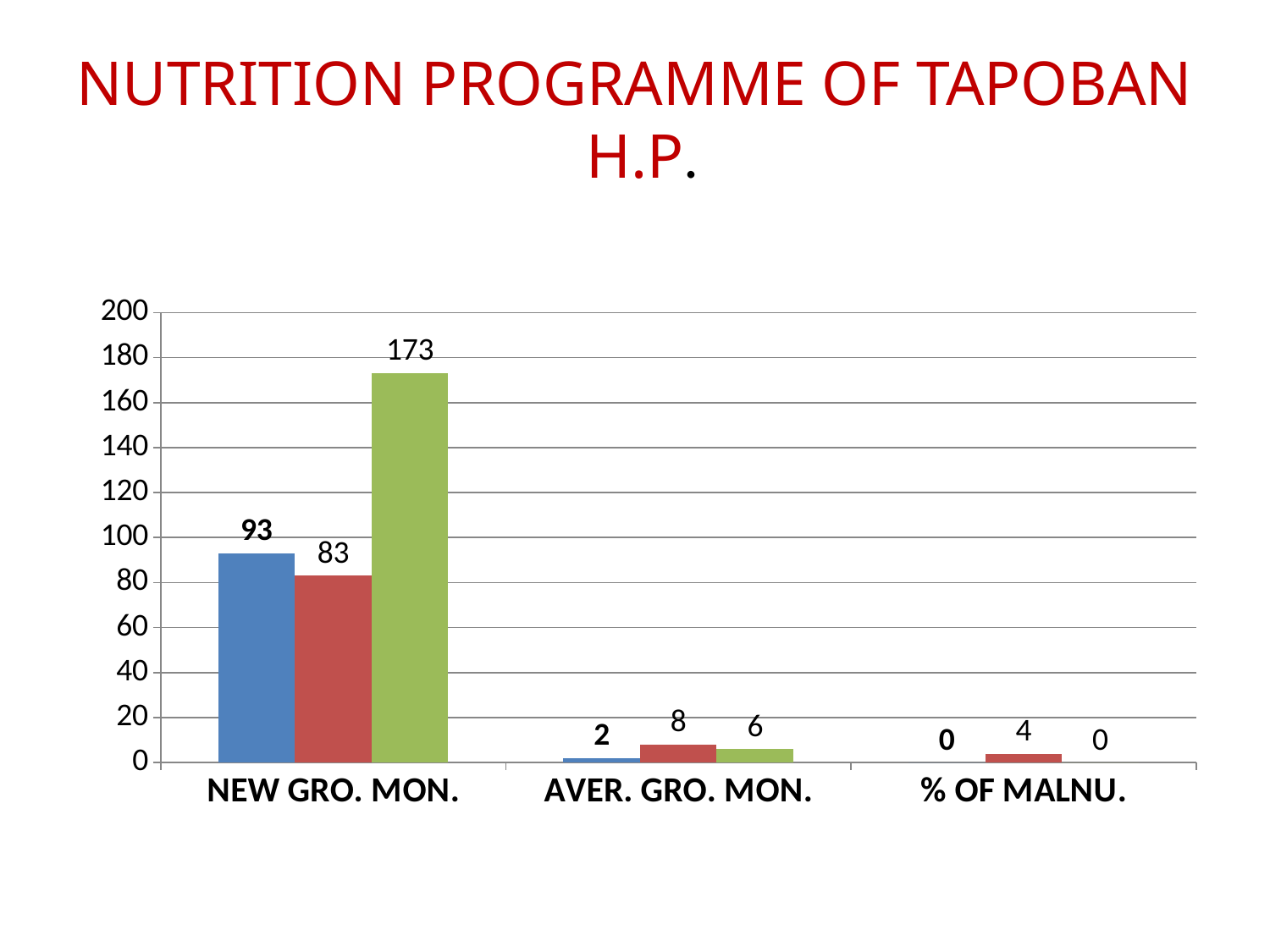
Is the value of the green bar for NEW GRO. MON. greater or less than 160? greater How many categories are shown on the x axis? 3 What kind of chart is shown on the slide? bar chart What is the difference between the green bar and the red bar for NEW GRO. MON.? 90 What is the value of the green bar for NEW GRO. MON.? 173 What is the value of the red bar for AVER. GRO. MON.? 8 Which category has the tallest bar on the chart? NEW GRO. MON. For AVER. GRO. MON., which is larger, the red bar or the green bar? the red bar What is the difference between the blue bar and the red bar for NEW GRO. MON.? 10 What is the value of the blue bar for NEW GRO. MON.? 93 What is the value of the red bar for % OF MALNU.? 4 What is the title of the slide? NUTRITION PROGRAMME OF TAPOBAN H.P.